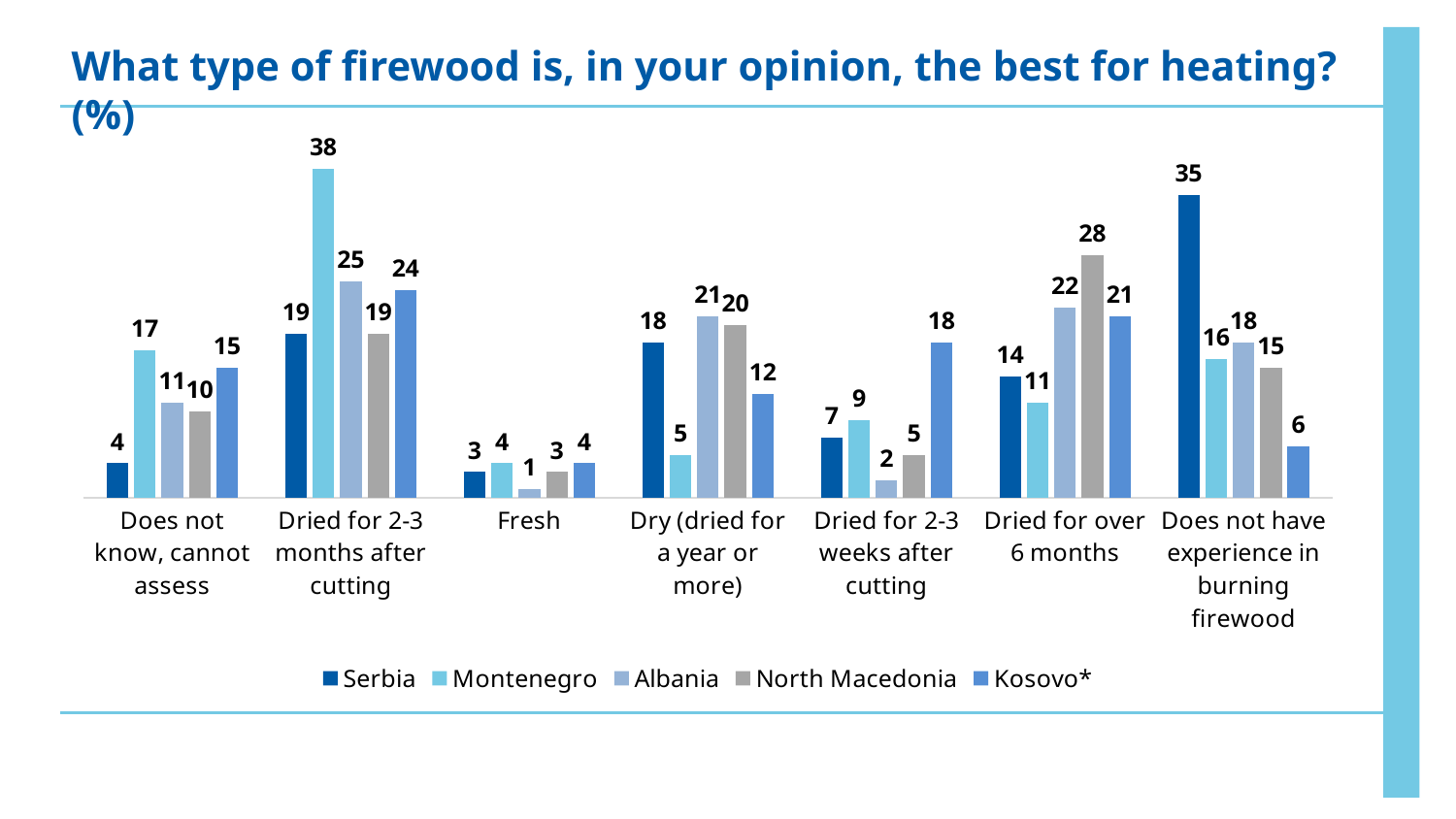
What is the value for Serbia in the "Does not have experience in burning firewood" category? 35 Which is larger in the "Does not know, cannot assess" category: Montenegro or Kosovo*? Montenegro What is the value for Montenegro in the "Dried for 2-3 months after cutting" category? 38 What is the value for North Macedonia in the "Dried for over 6 months" category? 28 What is the difference between Montenegro and Serbia in the "Dried for 2-3 months after cutting" category? 19 How many series does the legend list? 5 What kind of chart is shown on the slide? Bar chart How many categories are shown on the x axis? 7 Which series is shown in the darkest blue colour in the legend? Serbia Which country has the lowest value in the "Fresh" category? Albania What is the value for Kosovo* in the "Dried for 2-3 weeks after cutting" category? 18 Which country has the highest value in the "Dry (dried for a year or more)" category? Albania